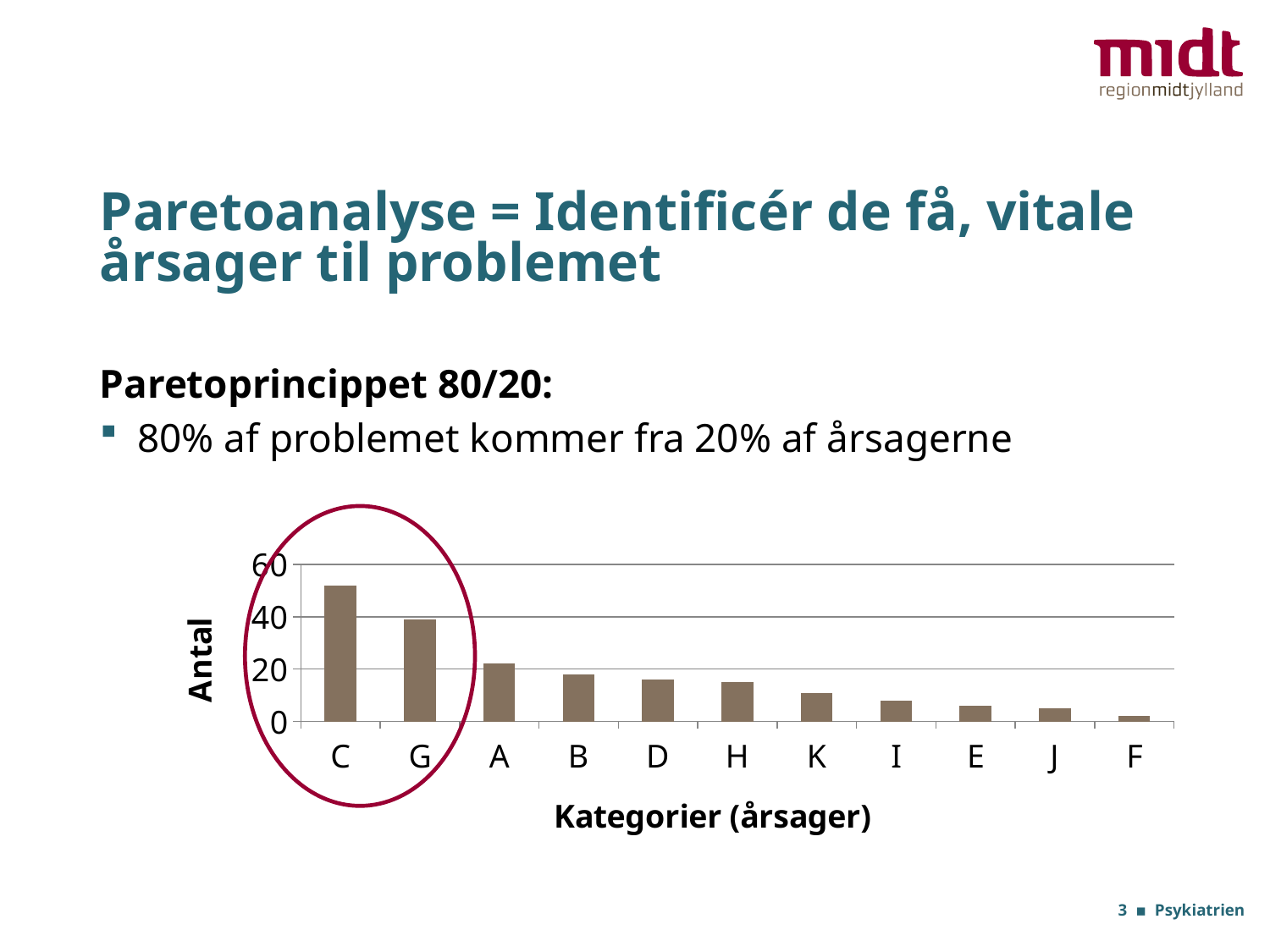
Is the value for G greater or less than 20? greater Do the bar values rise or fall from left to right along the x axis? fall Which category has the lowest value in the chart? F Which category has the highest value in the chart? C What is the title of the y axis of the chart? Antal Which has the larger value, C or G? C Is the value for K greater or less than 20? less Which two categories are circled on the chart? C and G What kind of chart is shown on the slide? bar chart Is the value for C greater or less than 40? greater How many categories are shown on the x axis of the chart? 11